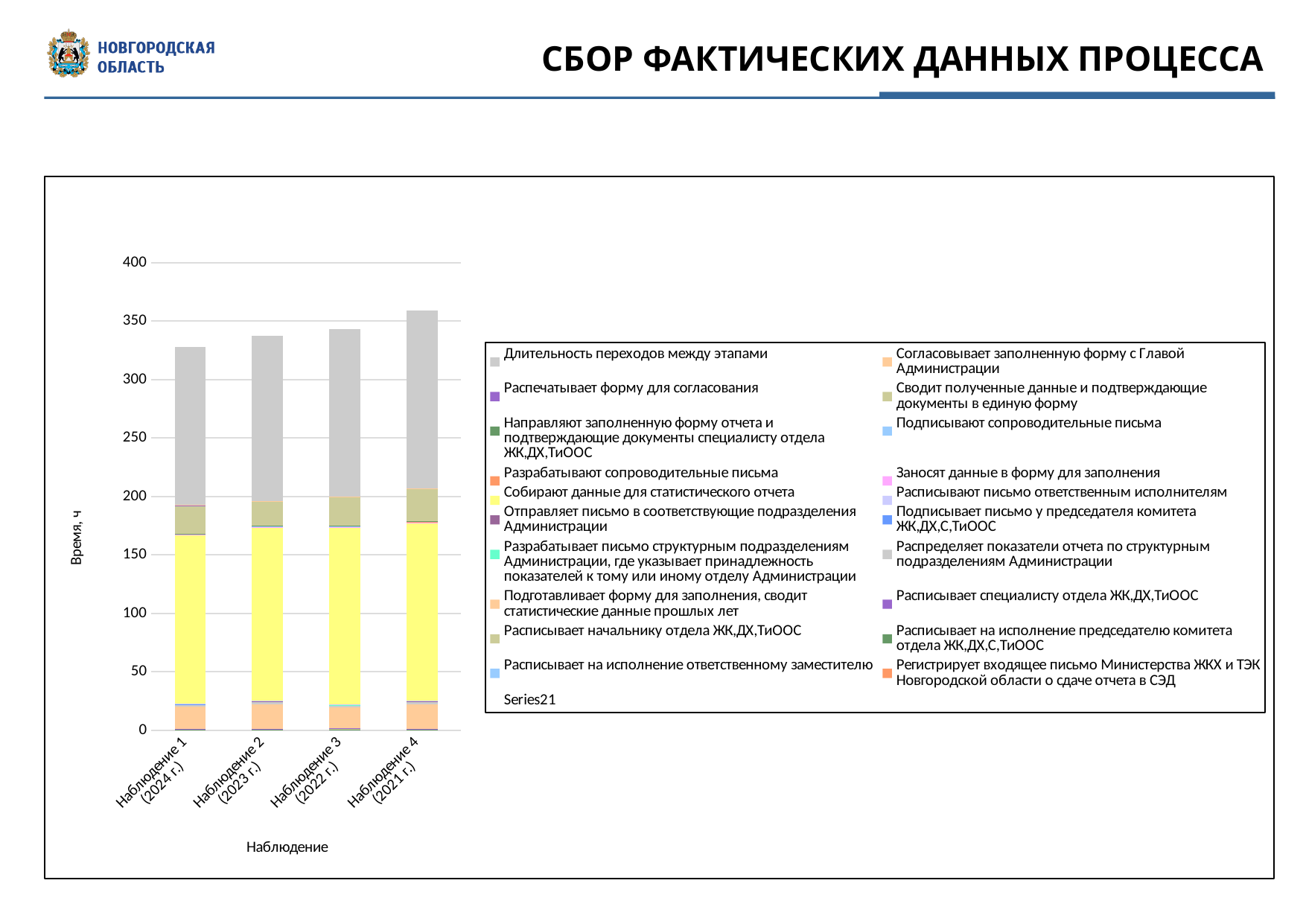
Is the total for Наблюдение 1 (2024 г.) greater or less than 350? less What kind of chart is shown on the slide? Stacked bar chart What is the title of the vertical axis of the chart? Время, ч How many observation categories are shown on the x axis of the chart? 4 Which observation has the shortest stacked bar? Наблюдение 1 (2024 г.) Is the total for Наблюдение 2 (2023 г.) greater or less than 300? greater Is the total for Наблюдение 4 (2021 г.) greater or less than 350? greater What is the title of the horizontal axis of the chart? Наблюдение How many series does the chart legend list? 21 Which observation has the tallest stacked bar? Наблюдение 4 (2021 г.) Do the bar totals rise or fall from Наблюдение 1 to Наблюдение 4 along the x axis? Rise Which stacked bar is taller: Наблюдение 1 (2024 г.) or Наблюдение 4 (2021 г.)? Наблюдение 4 (2021 г.)